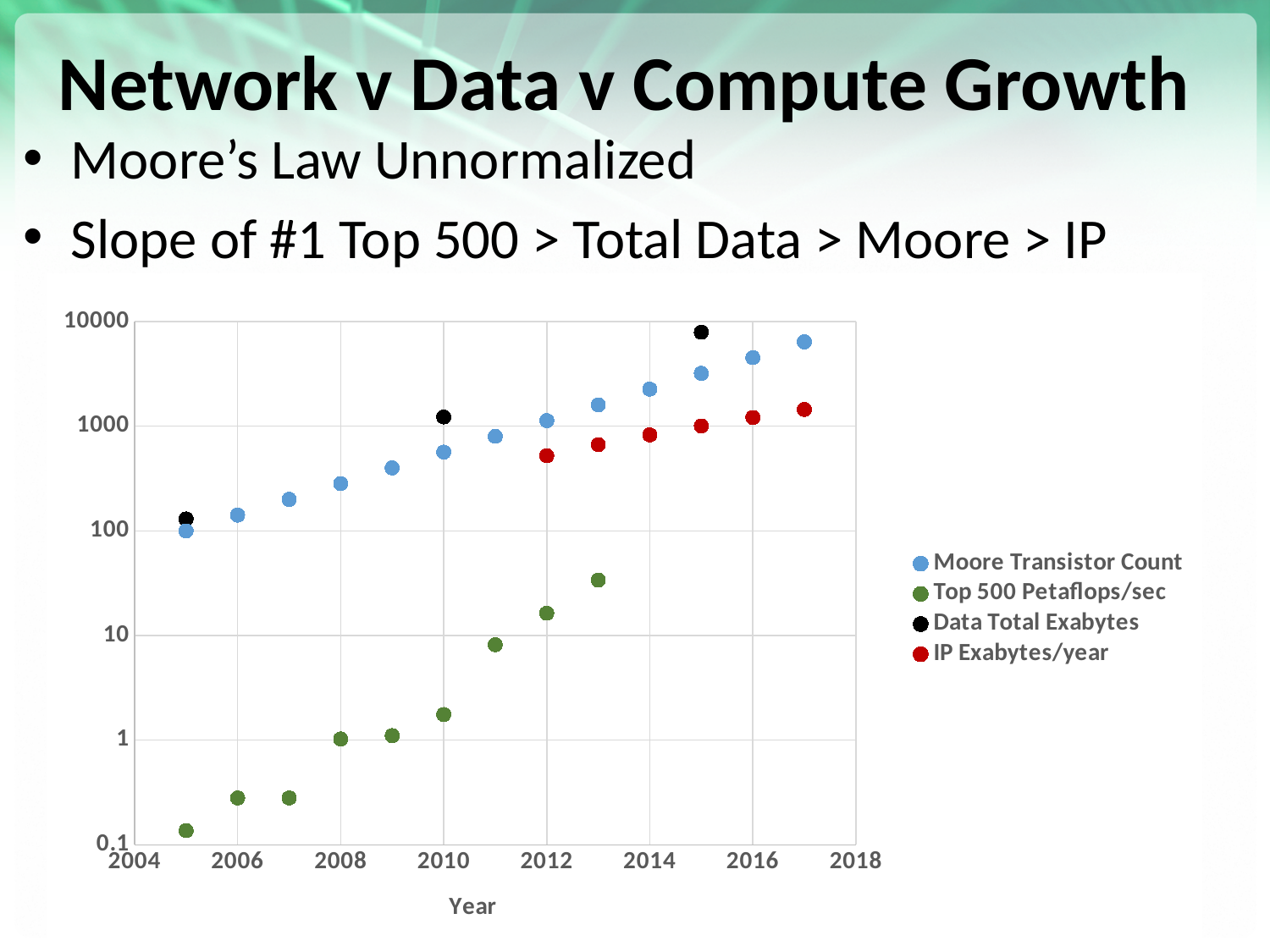
How many data points are plotted for the IP Exabytes/year series? 6 In 2015, which is larger: the Data Total Exabytes value or the Moore Transistor Count value? Data Total Exabytes What kind of chart is shown on the slide? scatter chart How many data points are plotted for the Data Total Exabytes series? 3 What is the title of the x axis? Year How many series does the chart legend list? 4 Is the Top 500 Petaflops/sec value for 2005 greater or less than 1? less Is the IP Exabytes/year value for 2012 greater or less than 1000? less Is the Data Total Exabytes value for 2015 greater or less than 1000? greater Do the Moore Transistor Count values rise or fall from 2005 to 2017? rise Which series is plotted with red markers? IP Exabytes/year